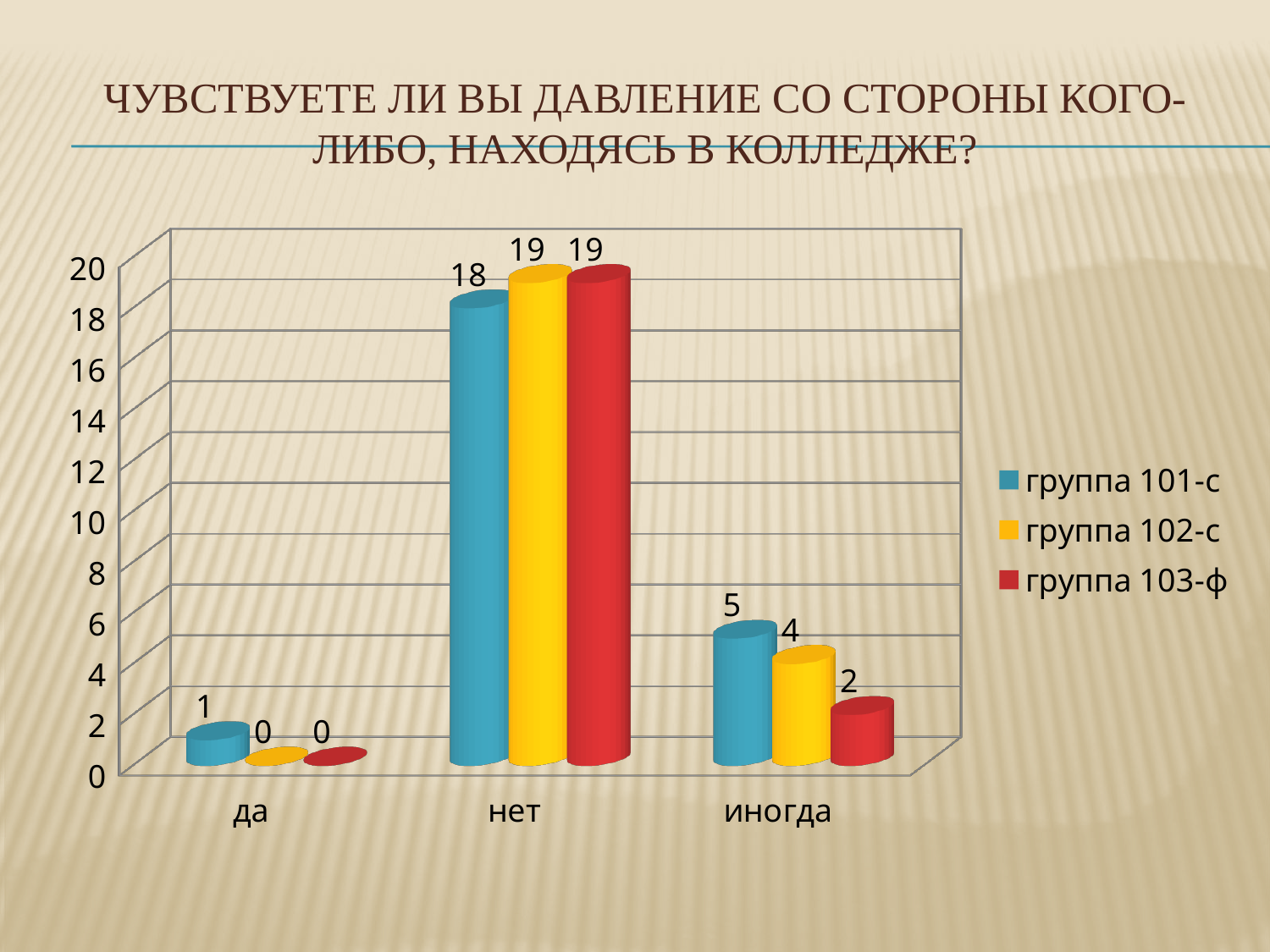
What is the value for группа 103-ф in the category иногда? 2 What is the value for группа 101-с in the category нет? 18 What kind of chart is shown on the slide? bar chart How many categories are shown on the x axis? 3 What is the total of the three series' values in the category да? 1 What is the difference between the values for группа 101-с and группа 103-ф in the category иногда? 3 What is the value for группа 102-с in the category да? 0 In the category нет, which is larger: the value for группа 101-с or группа 102-с? группа 102-с Is the value for группа 101-с in the category иногда greater or less than 4? greater Which series has the lowest value in the category иногда? группа 103-ф Which category has the highest value for группа 102-с? нет How many series does the legend list? 3